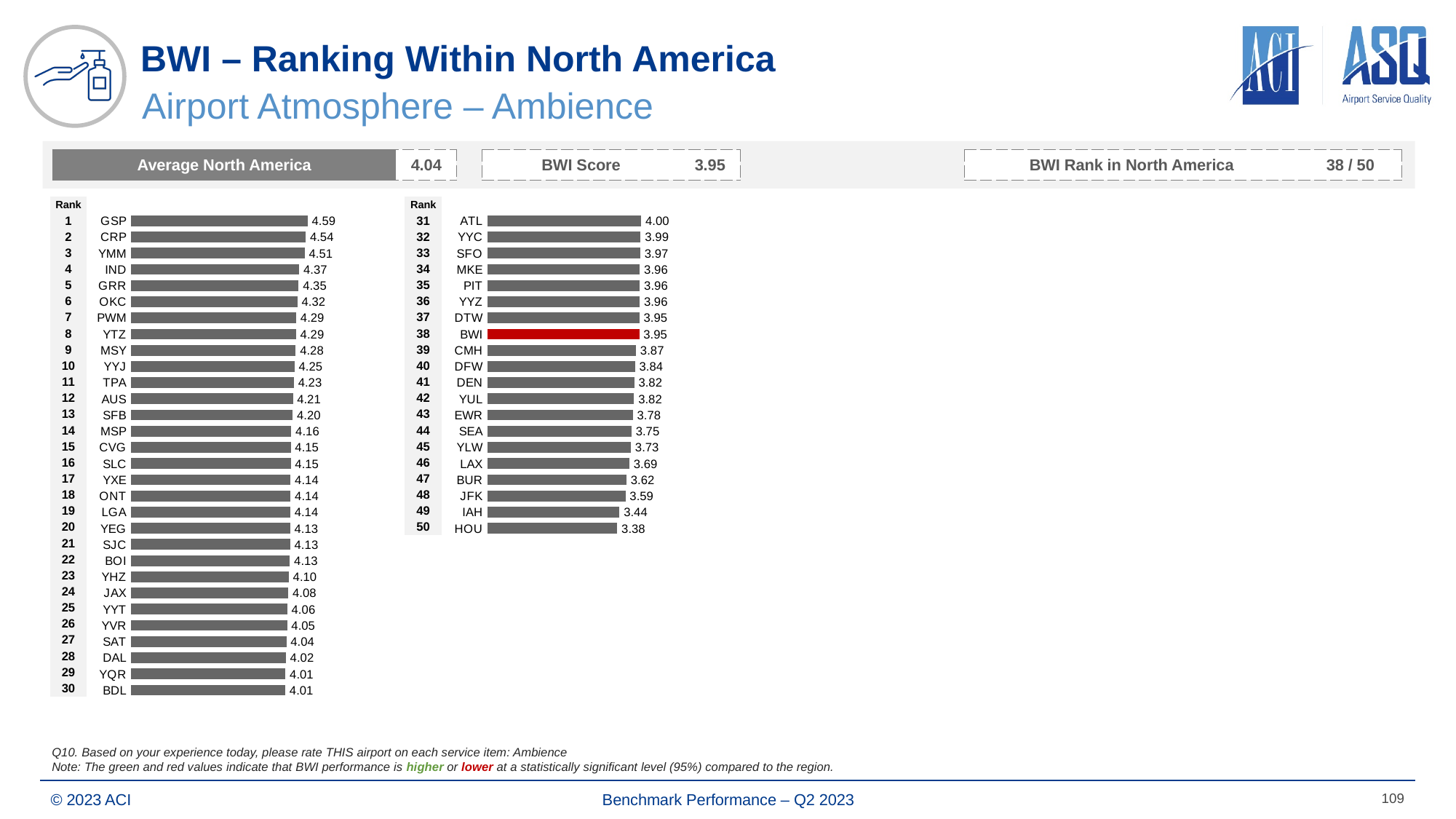
In the right chart (ranks 31-50), what is the value for HOU? 3.38 What is the difference between the values for GSP and BDL in the left chart (ranks 1-30)? 0.58 In the left chart (ranks 1-30), what is the value for GSP? 4.59 In the right chart (ranks 31-50), which airport's bar is coloured red? BWI In the right chart (ranks 31-50), do the values rise or fall as rank increases from 31 to 50? Fall In the left chart (ranks 1-30), which airport has the highest value? GSP In the right chart (ranks 31-50), what is the value for BWI? 3.95 In the right chart (ranks 31-50), which airport has the lowest value? HOU How many airports are plotted in the left chart (ranks 1-30)? 30 How many airports are plotted in the right chart (ranks 31-50)? 20 What kind of chart is used to show the airport rankings on this slide? Bar chart In the right chart (ranks 31-50), which has a larger value, ATL or LAX? ATL